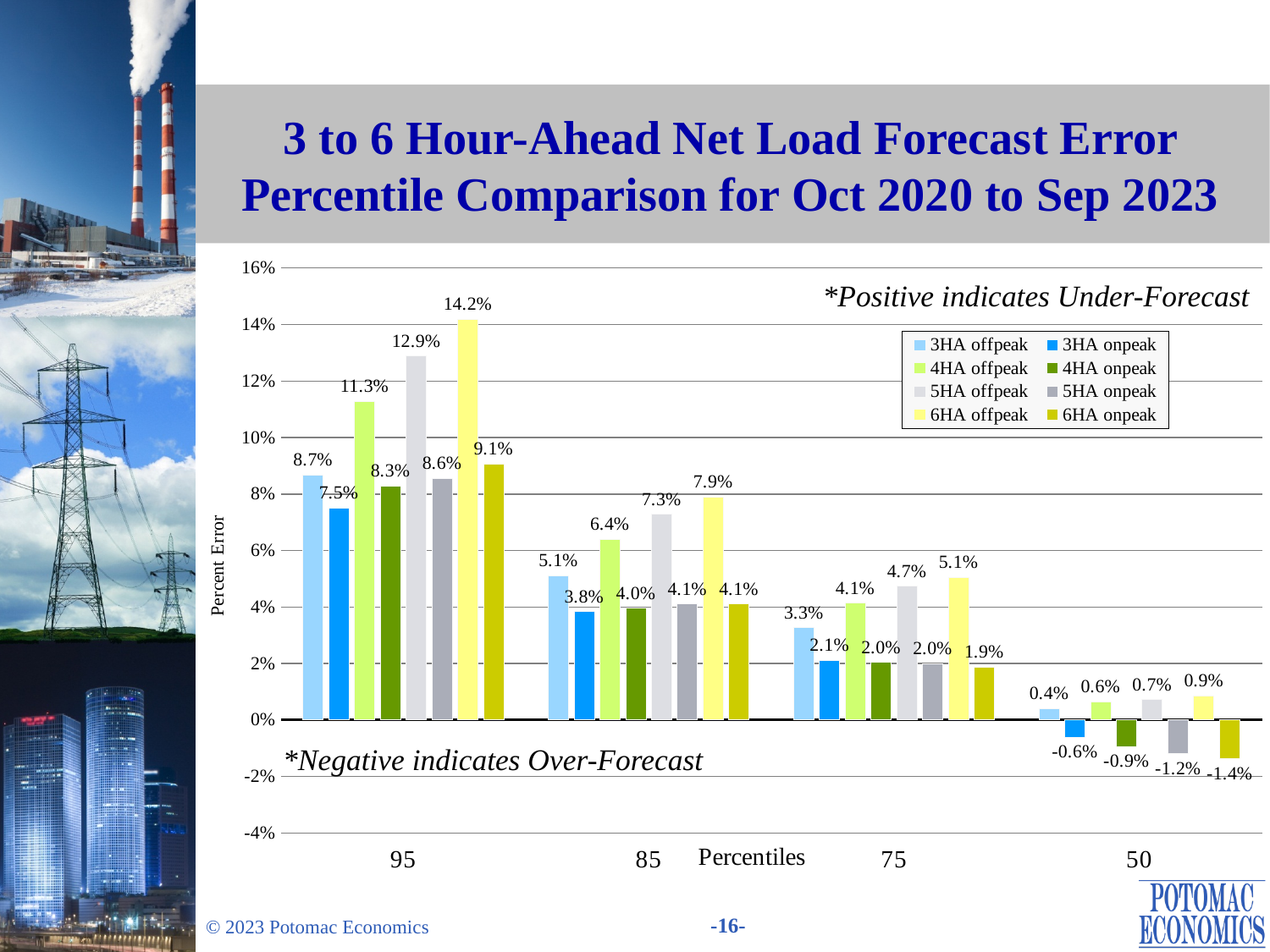
How many series does the legend list? 8 What is the value for 5HA onpeak at the 50th percentile? -1.2% Is the value for 5HA offpeak at the 95th percentile greater or less than 12%? greater How many percentile categories are shown on the x axis? 4 What kind of chart is shown on the slide? bar chart What is the value for 6HA offpeak at the 95th percentile? 14.2% Which series has the highest value at the 95th percentile? 6HA offpeak Do the 6HA offpeak values rise or fall moving from the 95th percentile to the 50th percentile? fall What is the value for 3HA onpeak at the 85th percentile? 3.8% At the 85th percentile, which is larger: 5HA offpeak or 4HA offpeak? 5HA offpeak What is the difference between the 6HA offpeak and 3HA offpeak values at the 95th percentile? 5.5% Which series has the lowest value at the 50th percentile? 6HA onpeak